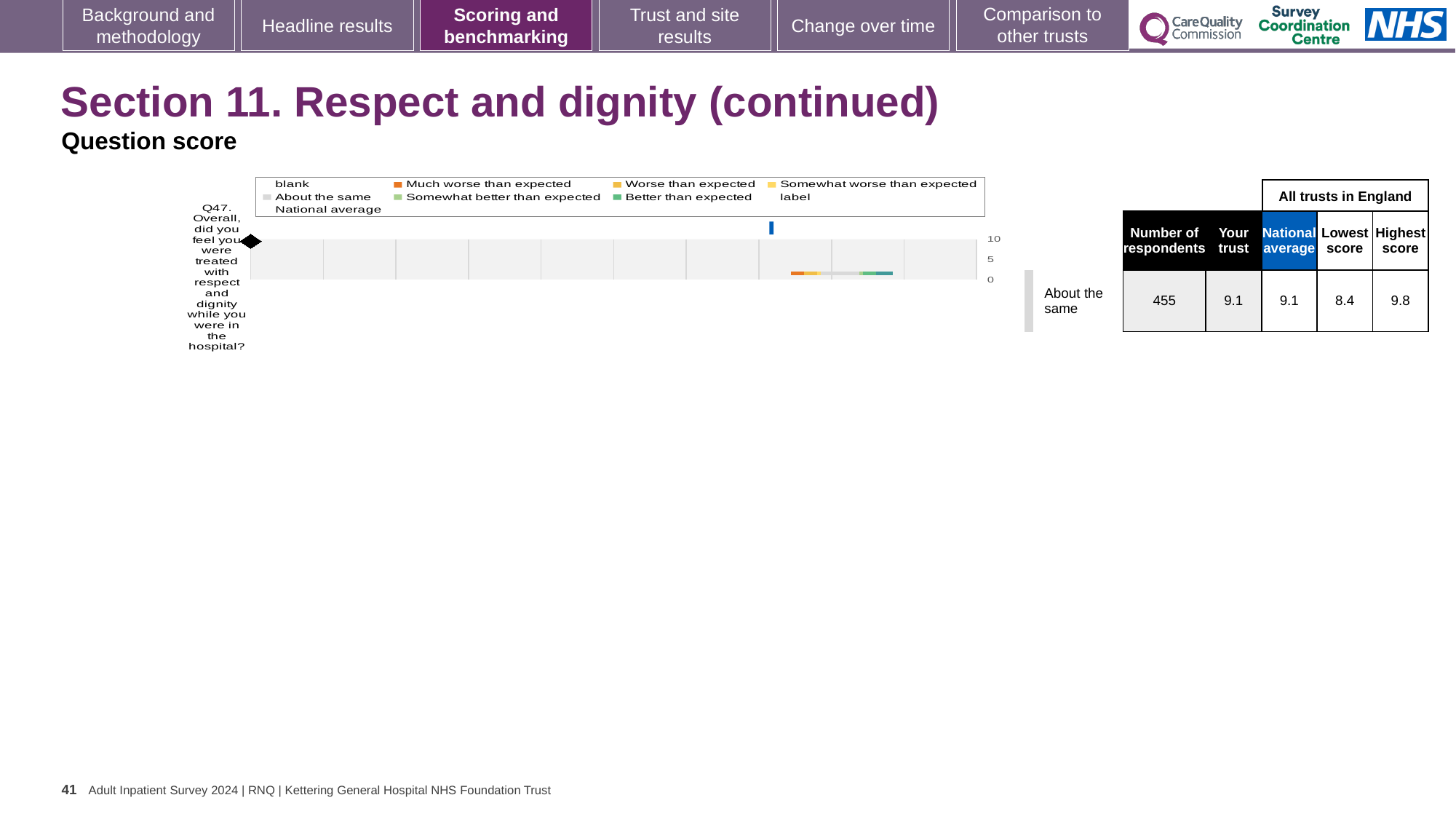
What is the difference between the highest and lowest scores for Q47 in the table beside the chart? 1.4 What is the lowest score among all trusts in England for Q47? 8.4 How many respondents are listed for Q47 in the table beside the chart? 455 How many survey questions are plotted in the chart? 1 What is the national average score for Q47 in the table beside the chart? 9.1 What kind of chart is shown for Q47 on the slide? bar chart Is the 'Your trust' score for Q47 greater than, less than, or equal to the national average? equal What is the highest tick value shown on the chart's score axis? 10 What is the highest score among all trusts in England for Q47? 9.8 What is the 'Your trust' score for Q47 in the table beside the chart? 9.1 What benchmark category is shown for Q47 next to the chart? About the same Which question number is plotted in the chart? Q47